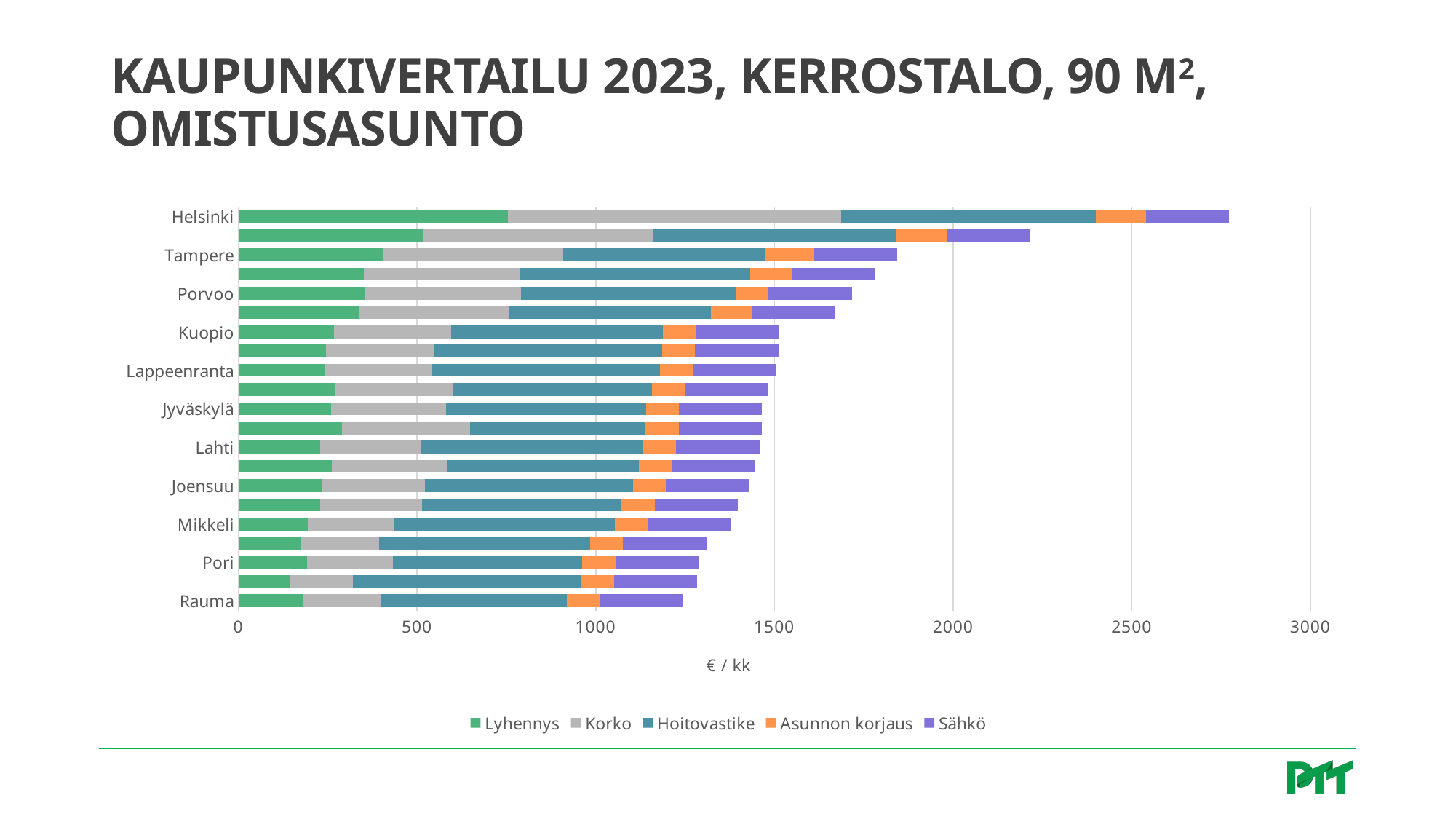
Is the Lyhennys value for Helsinki greater or less than 500? greater Which labeled city has the shortest total bar? Rauma Is the total value for Mikkeli greater or less than 1500? less What is the label on the horizontal axis? € / kk Is the total value for Porvoo greater or less than 1500? greater How many series does the legend list? 5 Which series is shown in purple in the legend? Sähkö Which has the larger total bar, Lappeenranta or Pori? Lappeenranta What kind of chart is shown on the slide? Stacked bar chart Which city has the longest total bar? Helsinki